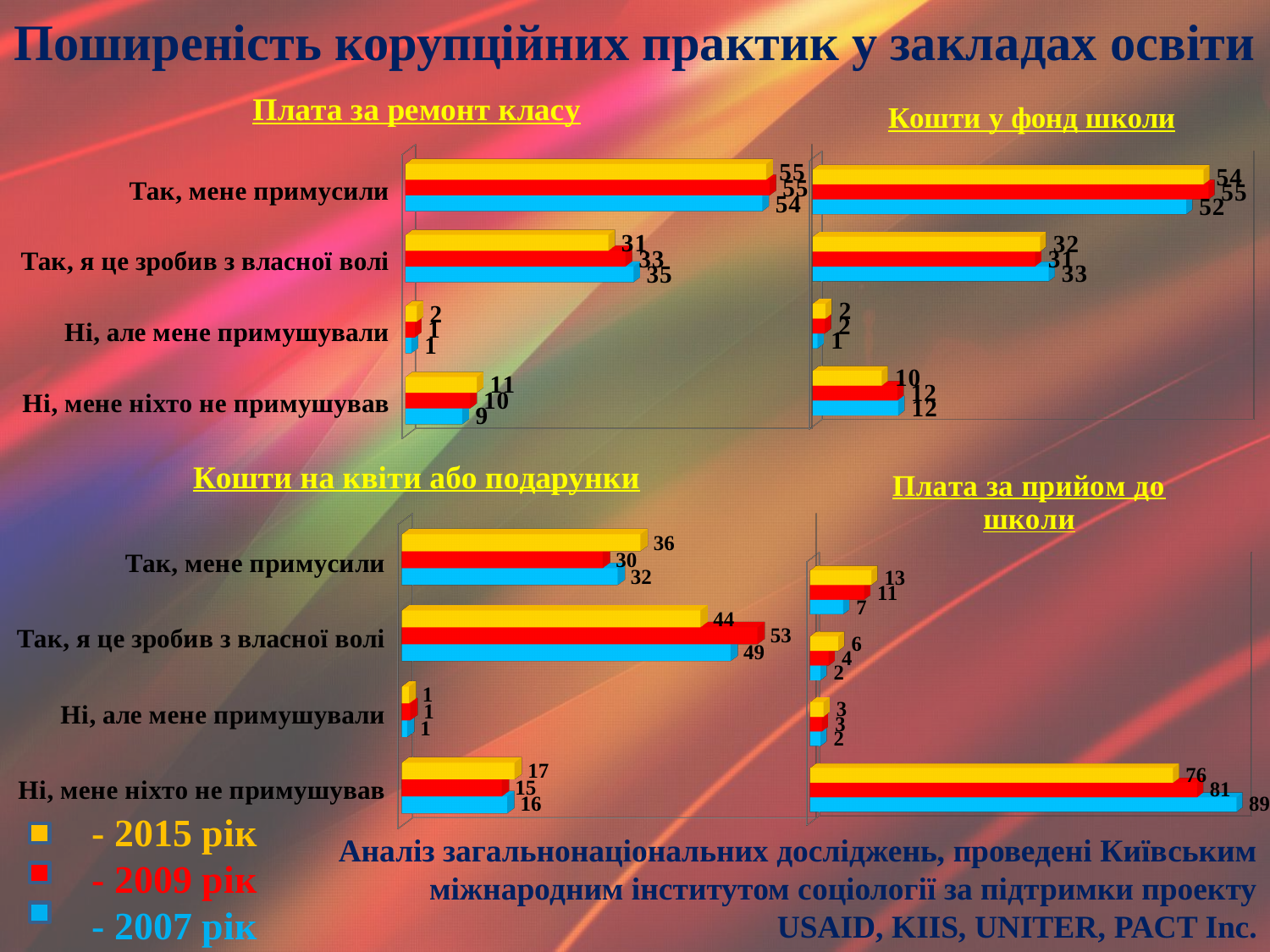
Which year does the yellow colour represent in the legend? 2015 рік In the chart "Кошти на квіти або подарунки", which category has the highest value in 2009? Так, я це зробив з власної волі How many categories does the chart "Кошти у фонд школи" show? 4 In the chart "Кошти на квіти або подарунки", which is larger for "Так, я це зробив з власної волі": the 2015 value or the 2009 value? 2009 In the chart "Плата за ремонт класу", what is the value for "Так, я це зробив з власної волі" in 2007? 35 In the chart "Плата за прийом до школи", what is the difference between the 2007 and 2015 values for "Ні, мене ніхто не примушував"? 13 In the chart "Кошти у фонд школи", what is the value for "Ні, мене ніхто не примушував" in 2009? 12 In the chart "Плата за ремонт класу", what is the value for "Так, мене примусили" in 2015? 55 What type of chart is "Кошти на квіти або подарунки"? Bar chart How many series does the legend list? 3 In the chart "Плата за прийом до школи", what is the value for "Так, мене примусили" in 2015? 13